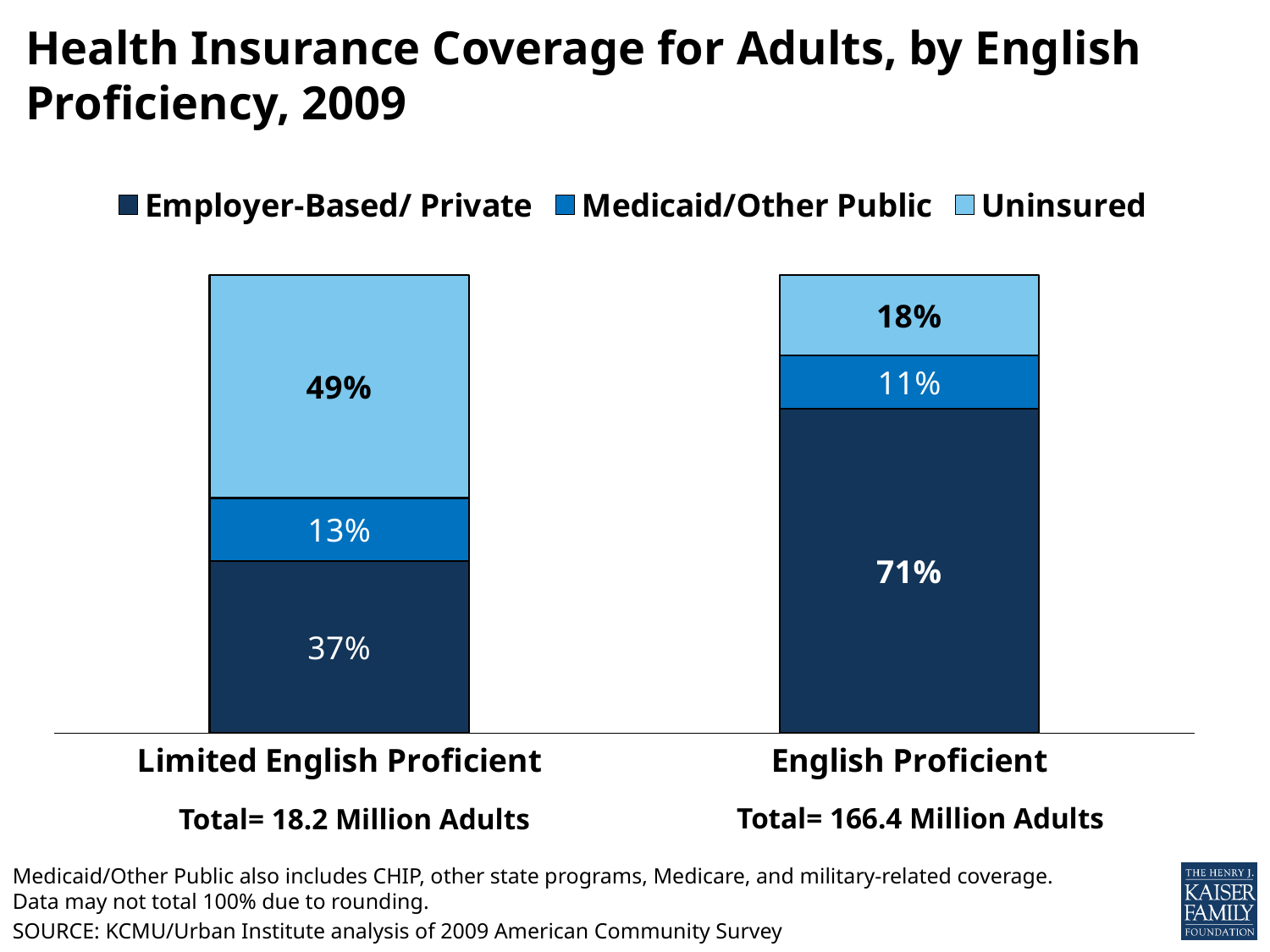
How many series does the legend list? 3 What percentage of English Proficient adults have Employer-Based/Private coverage? 71% How many categories are shown on the x axis? 2 What is the difference in the Uninsured share between Limited English Proficient and English Proficient adults? 31 percentage points What is the Uninsured share for English Proficient adults? 18% Which coverage type is the largest segment for Limited English Proficient adults? Uninsured What percentage of Limited English Proficient adults are uninsured? 49% What kind of chart is shown on the slide? Stacked bar chart Which coverage type is the smallest segment for English Proficient adults? Medicaid/Other Public Which category has the higher Employer-Based/Private share, Limited English Proficient or English Proficient? English Proficient What is the Medicaid/Other Public share for Limited English Proficient adults? 13% What is the difference in the Employer-Based/Private share between English Proficient and Limited English Proficient adults? 34 percentage points